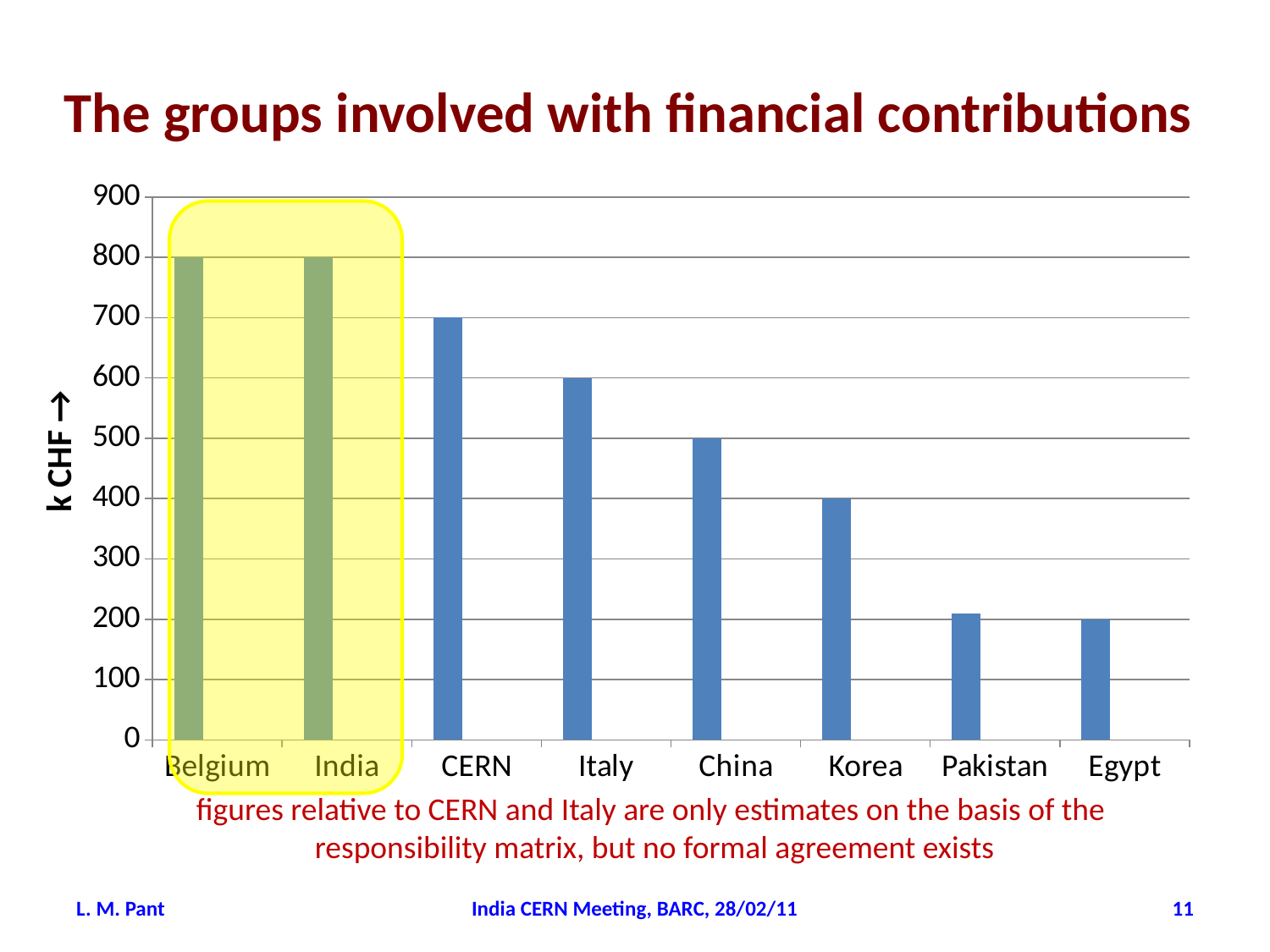
Do the values generally rise or fall from left to right along the x axis? fall What is the value for Belgium? 800 What is the value for Korea? 400 What kind of chart is shown on the slide? bar chart How many categories are shown on the x axis? 8 Is the value for Pakistan greater or less than 300? less What is the difference between the values for CERN and Korea? 300 What is the value for China? 500 What is the value for Egypt? 200 Which is larger, the value for Italy or the value for China? Italy What is the value for CERN? 700 What is the value for Italy? 600